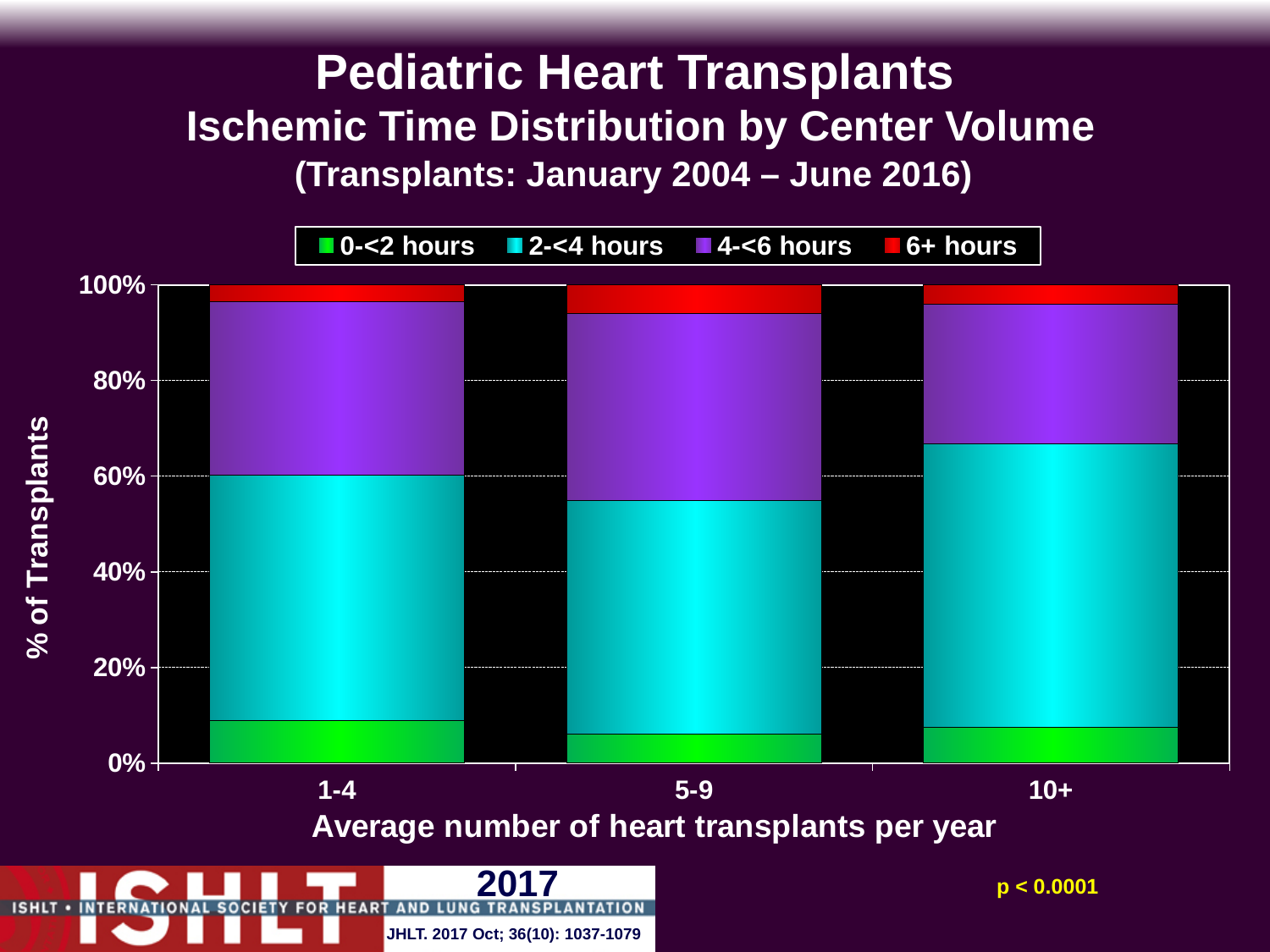
What kind of chart is shown on the slide? Stacked bar chart Is the cumulative top of the 2-<4 hours segment for the 5-9 category greater or less than 60%? less What is the label of the x axis? Average number of heart transplants per year Which category has the smallest 4-<6 hours share? 10+ Is the cumulative top of the 2-<4 hours segment for the 10+ category greater or less than 60%? greater Which category has the larger 2-<4 hours share, 5-9 or 10+? 10+ Which category has the larger 4-<6 hours share, 5-9 or 10+? 5-9 How many series does the legend list? 4 Is the 0-<2 hours share for the 1-4 category greater or less than 20%? less How many center volume categories are shown on the x axis? 3 What are the four ischemic time categories listed in the legend? 0-<2 hours, 2-<4 hours, 4-<6 hours, 6+ hours What is the total height of the stacked bar for the 1-4 category? 100%